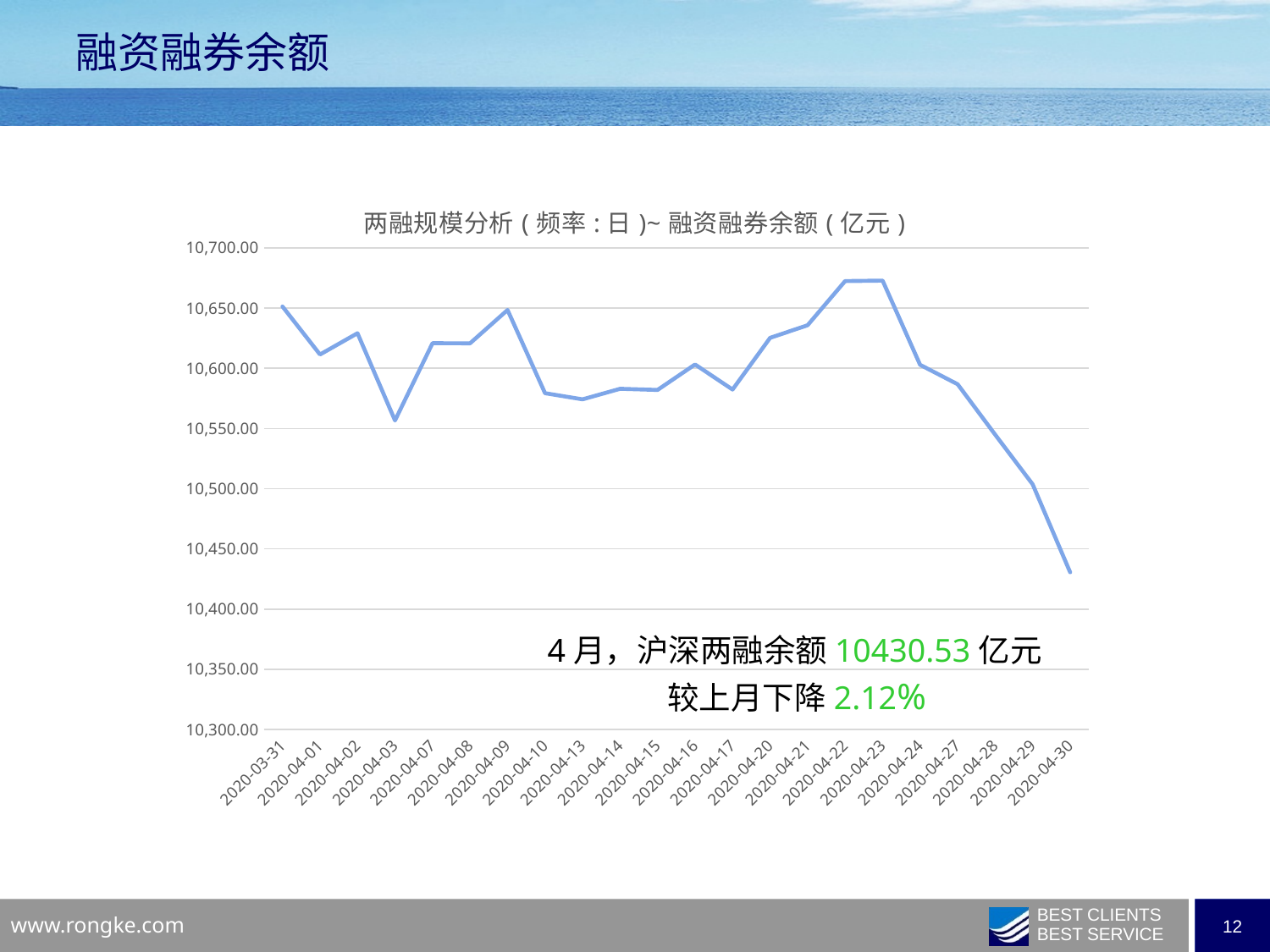
Is the value for 2020-04-10 greater or less than 10,600.00? less Which date has the lowest value in the chart? 2020-04-30 Is the value for 2020-04-30 greater or less than 10,450.00? less What is the 沪深两融余额 value for 2020-04-30 as stated on the slide? 10430.53 亿元 Which is larger, the value for 2020-04-03 or the value for 2020-04-09? 2020-04-09 Is the value for 2020-04-27 greater or less than 10,600.00? less Which is larger, the value for 2020-03-31 or the value for 2020-04-30? 2020-03-31 How many dates are plotted along the x axis of the chart? 22 Overall, does the value rise or fall from 2020-03-31 to 2020-04-30? fall What is the title of the chart? 两融规模分析（频率：日）~ 融资融券余额（亿元） What kind of chart is shown on the slide? line chart